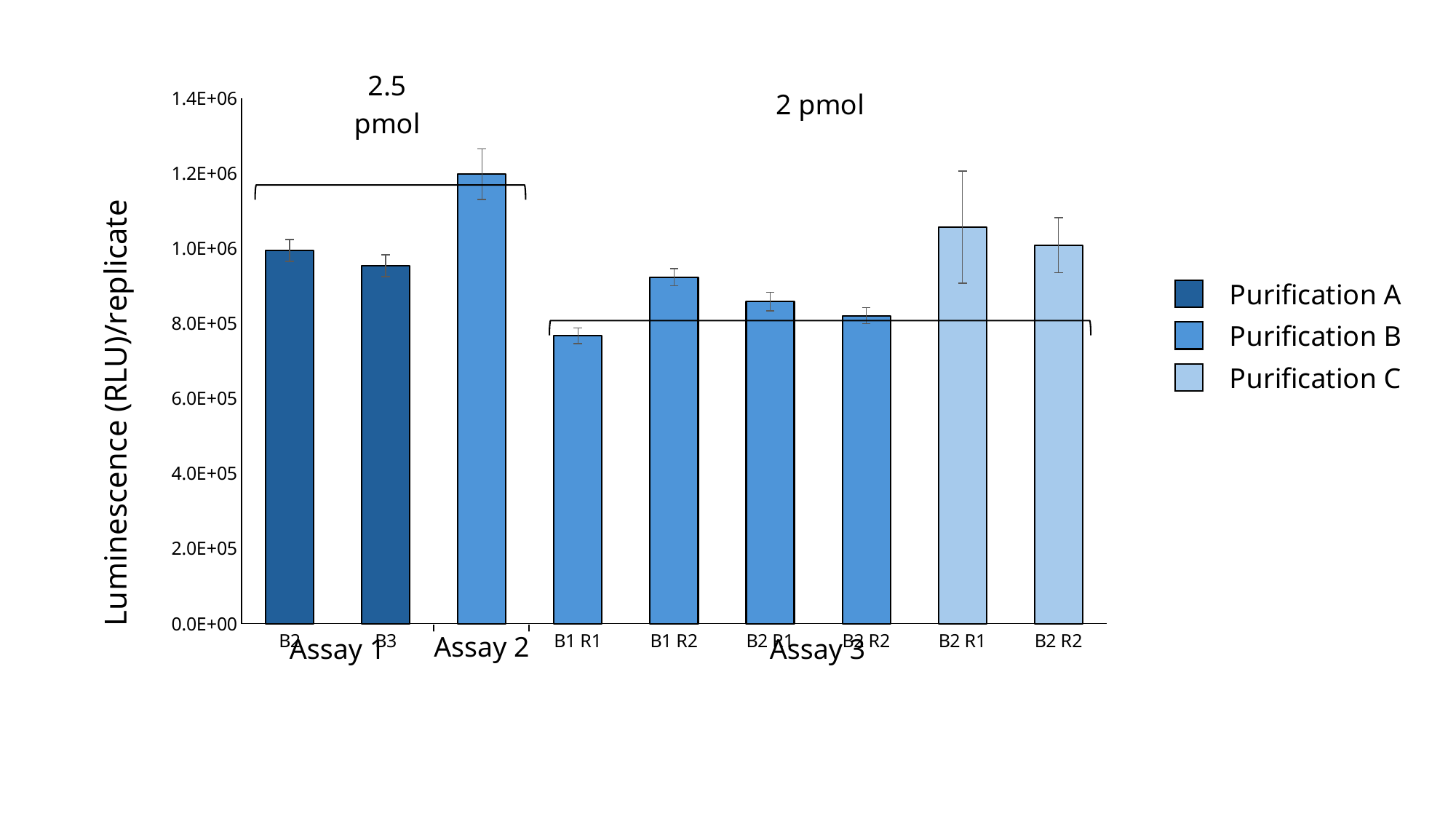
Is the value for B1 R2 greater or less than 8.0E+05? greater How many bars are plotted in the chart? 9 Which bar has the highest luminescence value? Assay 2 Is the value for the Assay 2 bar greater or less than 1.0E+06? greater Which legend entry is shown with the lightest blue colour? Purification C Is the value for B3 in Assay 1 greater or less than 8.0E+05? greater How many series does the legend list? 3 Which bar has the lowest luminescence value? B1 R1 Which is larger, the value for Assay 2 or the value for B1 R1? Assay 2 What kind of chart is shown on the slide? bar chart What is the y-axis title of the chart? Luminescence (RLU)/replicate